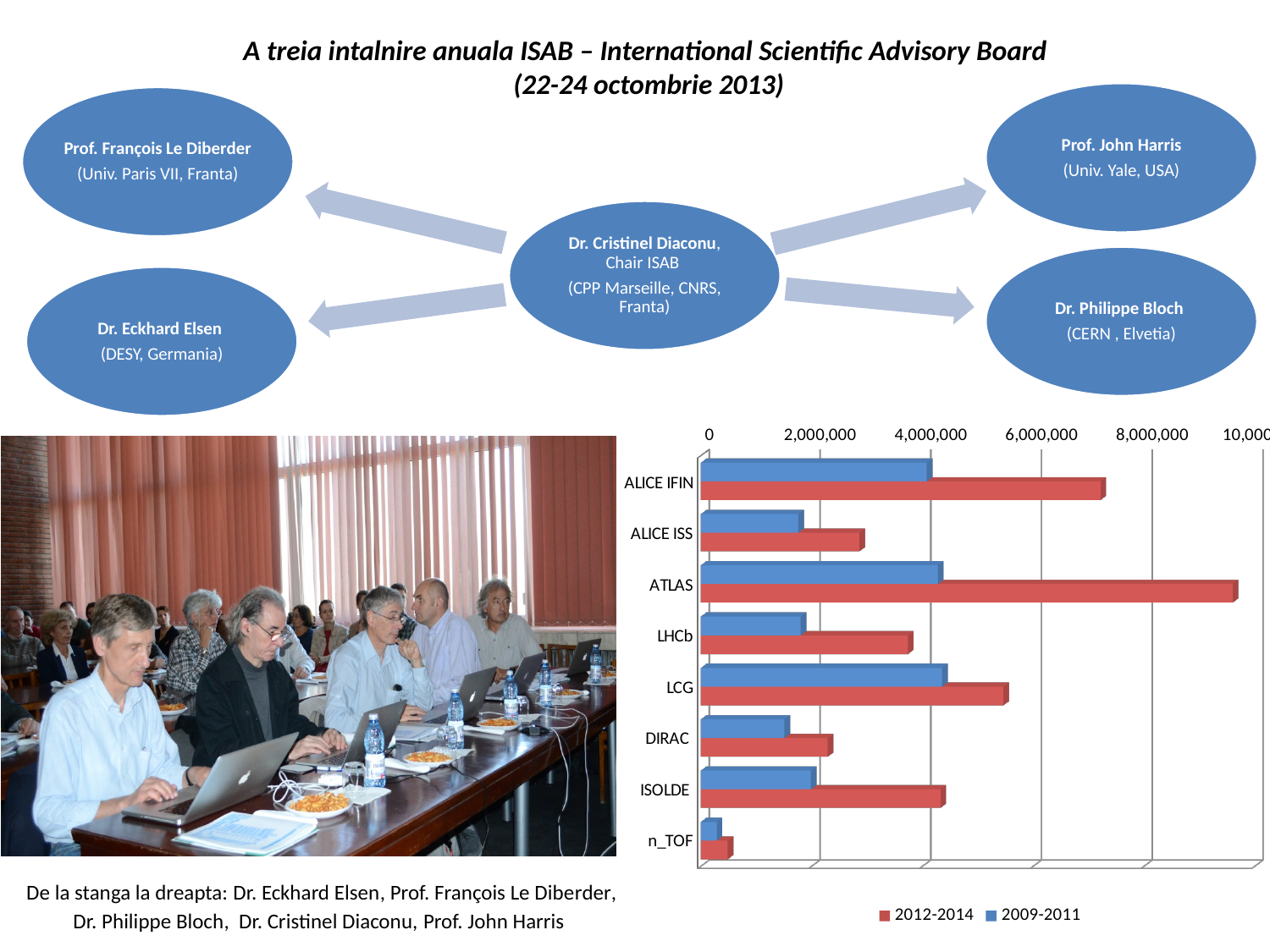
Which colour represents the 2009-2011 series in the chart? blue How many categories are shown on the chart? 8 Which category has the lowest value for the 2009-2011 series? n_TOF Which is larger for ISOLDE: the 2012-2014 value or the 2009-2011 value? 2012-2014 Is the 2012-2014 value for ATLAS greater or less than 8,000,000? greater Is the 2012-2014 value for ALICE IFIN greater or less than 6,000,000? greater Which is larger for the 2012-2014 series: LHCb or ALICE IFIN? ALICE IFIN Is the 2009-2011 value for DIRAC greater or less than 2,000,000? less Which category has the lowest value for the 2012-2014 series? n_TOF Which category has the highest value for the 2012-2014 series? ATLAS How many series does the chart legend list? 2 What kind of chart is shown on the slide? bar chart